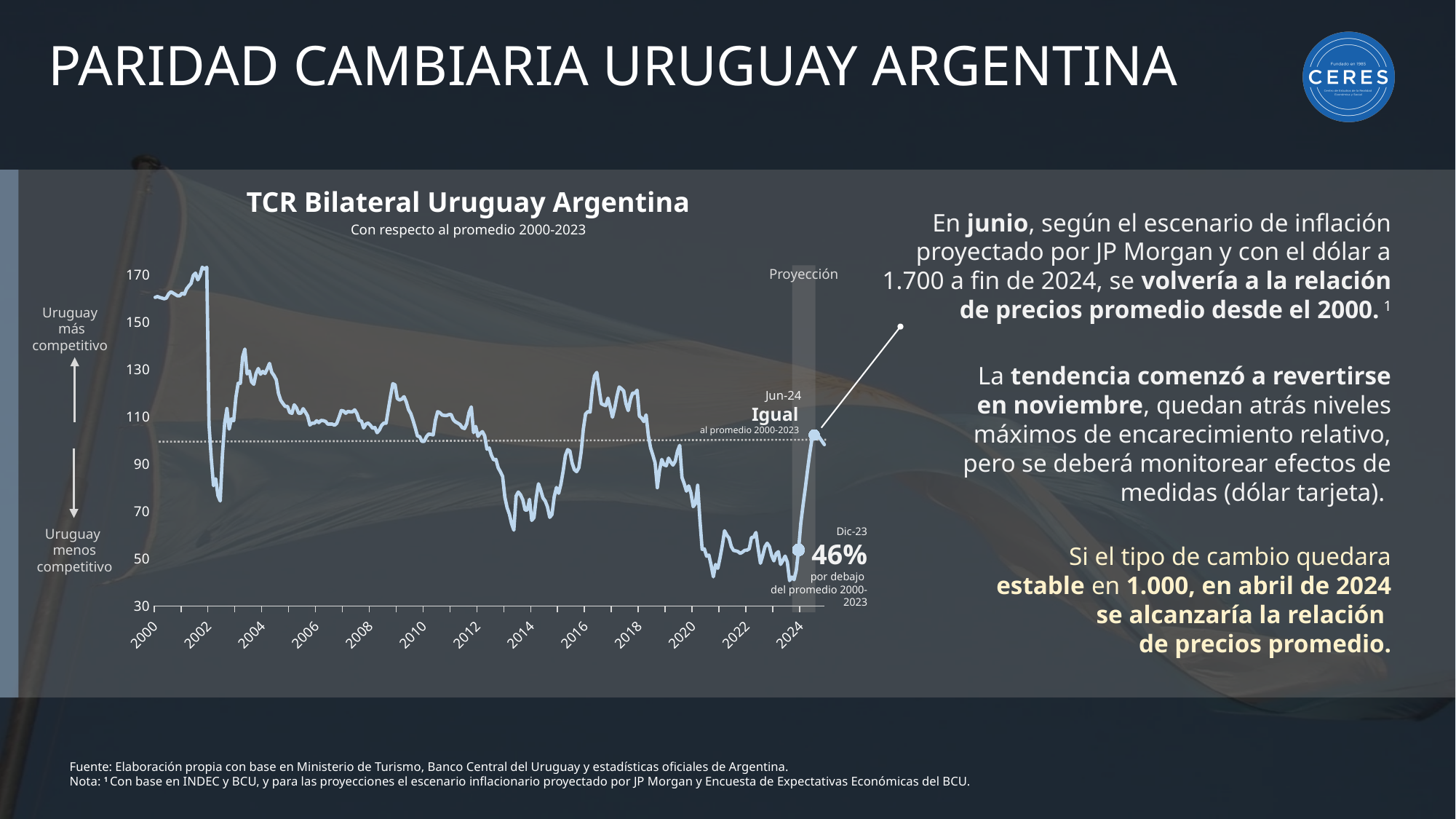
What is the highest value shown on the y axis of the chart? 170 What kind of chart is shown on the slide? Line chart Is the value of the TCR around 2014 greater or less than 90? less Does the TCR rise or fall between 2017 and 2021? Falls Is the value of the TCR around 2021 greater or less than 70? less According to the chart annotation, by what percentage was the TCR below the 2000-2023 average in Dic-23? 46% What is the title of the chart? TCR Bilateral Uruguay Argentina What is the first year labelled on the x axis of the chart? 2000 Does the TCR rise or fall between Dic-23 and the projected Jun-24? Rises According to the chart annotation, how does the projected Jun-24 value compare to the 2000-2023 average? Igual al promedio 2000-2023 Which is higher, the TCR value in 2000 or the TCR value in Dic-23? 2000 Is the value of the TCR at the start of 2000 greater or less than 150? greater